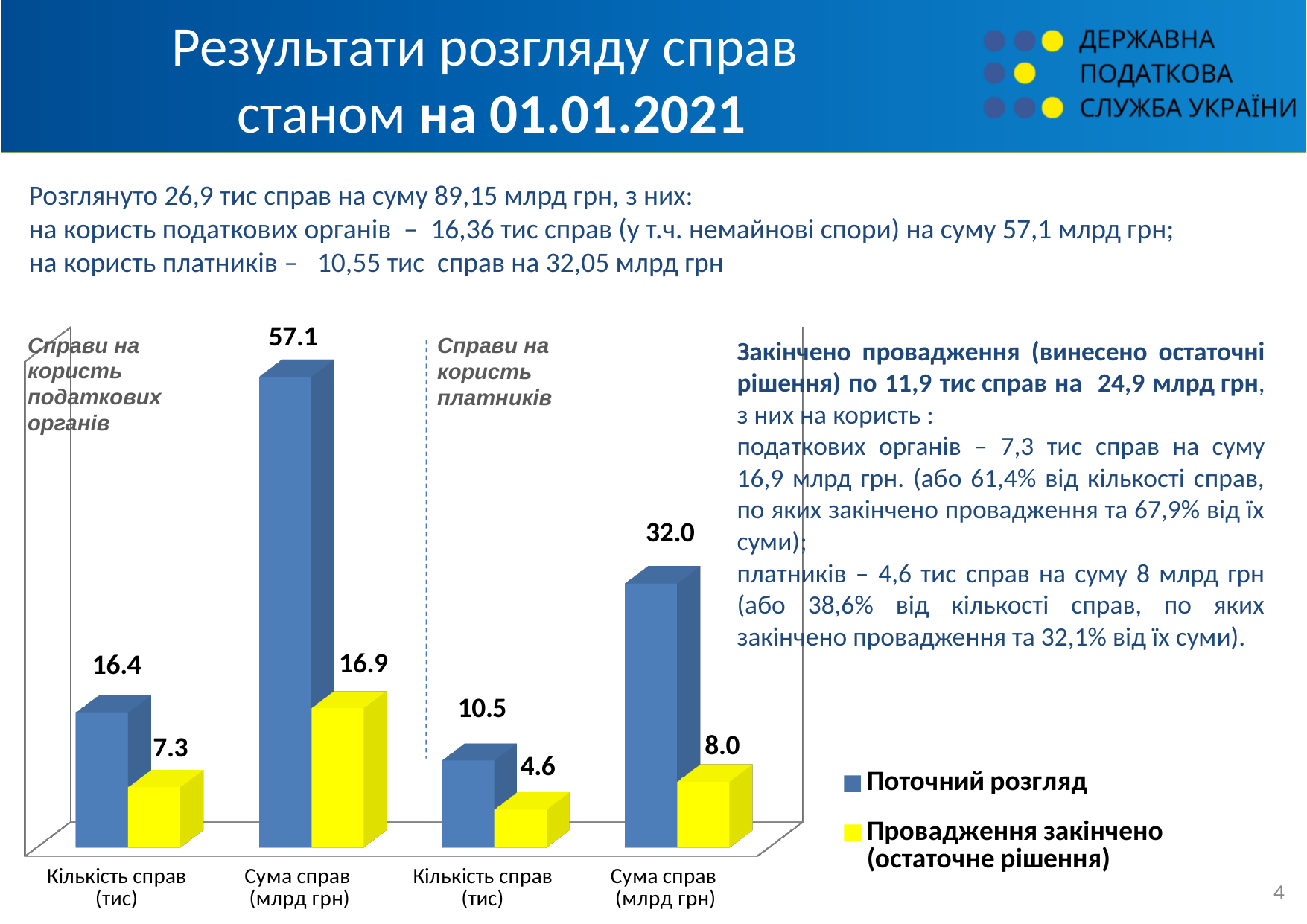
What is the value of 'Провадження закінчено (остаточне рішення)' for 'Кількість справ (тис)' in the group 'Справи на користь платників'? 4.6 How many series does the chart legend list? 2 What is the value of 'Провадження закінчено (остаточне рішення)' for 'Сума справ (млрд грн)' in the group 'Справи на користь платників'? 8.0 What is the value of 'Поточний розгляд' for 'Кількість справ (тис)' in the group 'Справи на користь податкових органів'? 16.4 Which is larger: 'Поточний розгляд' for 'Кількість справ (тис)' in the group 'Справи на користь податкових органів' or 'Поточний розгляд' for 'Кількість справ (тис)' in the group 'Справи на користь платників'? Справи на користь податкових органів How many categories are shown on the x axis of the chart? 4 Which bar in the 'Провадження закінчено (остаточне рішення)' series has the lowest value? Кількість справ (тис) in the group Справи на користь платників Which bar in the 'Поточний розгляд' series has the highest value? Сума справ (млрд грн) in the group Справи на користь податкових органів What colour are the bars for the 'Провадження закінчено (остаточне рішення)' series? yellow What type of chart is shown on the slide? bar chart What is the value of 'Поточний розгляд' for 'Сума справ (млрд грн)' in the group 'Справи на користь податкових органів'? 57.1 What is the difference between 'Поточний розгляд' and 'Провадження закінчено (остаточне рішення)' for 'Сума справ (млрд грн)' in the group 'Справи на користь платників'? 24.0